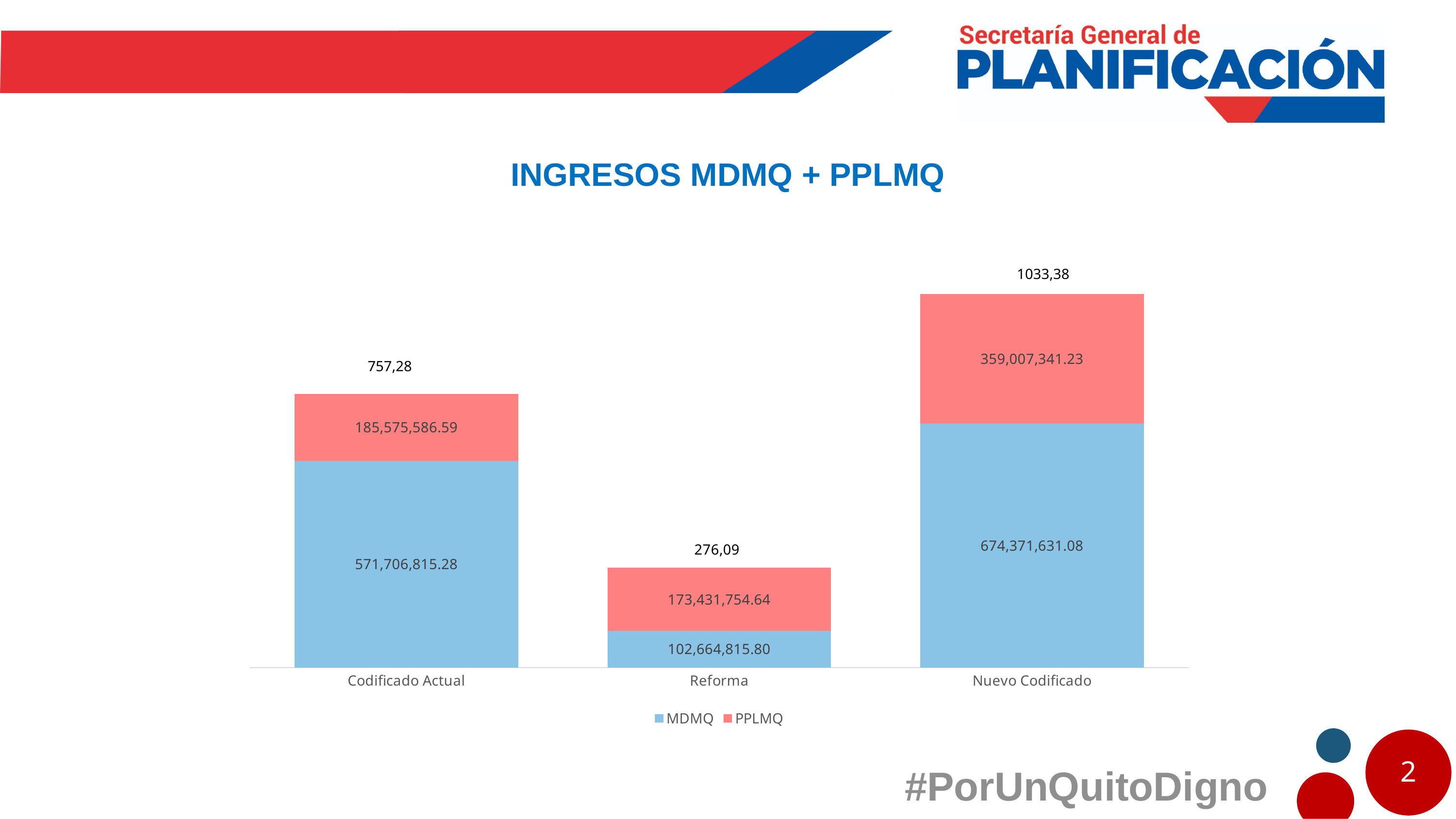
Which category has the lowest total bar? Reforma Which category has the highest total bar? Nuevo Codificado What is the PPLMQ value for Reforma? 173,431,754.64 What is the difference between the MDMQ value for Nuevo Codificado and the MDMQ value for Codificado Actual? 102,664,815.80 What total is printed above the Reforma bar? 276,09 What total is printed above the Nuevo Codificado bar? 1033,38 How many categories are shown on the x axis? 3 What is the MDMQ value for Nuevo Codificado? 674,371,631.08 In the Reforma bar, which is larger, MDMQ or PPLMQ? PPLMQ What is the MDMQ value for Codificado Actual? 571,706,815.28 What is the PPLMQ value for Nuevo Codificado? 359,007,341.23 How many series does the legend list? 2